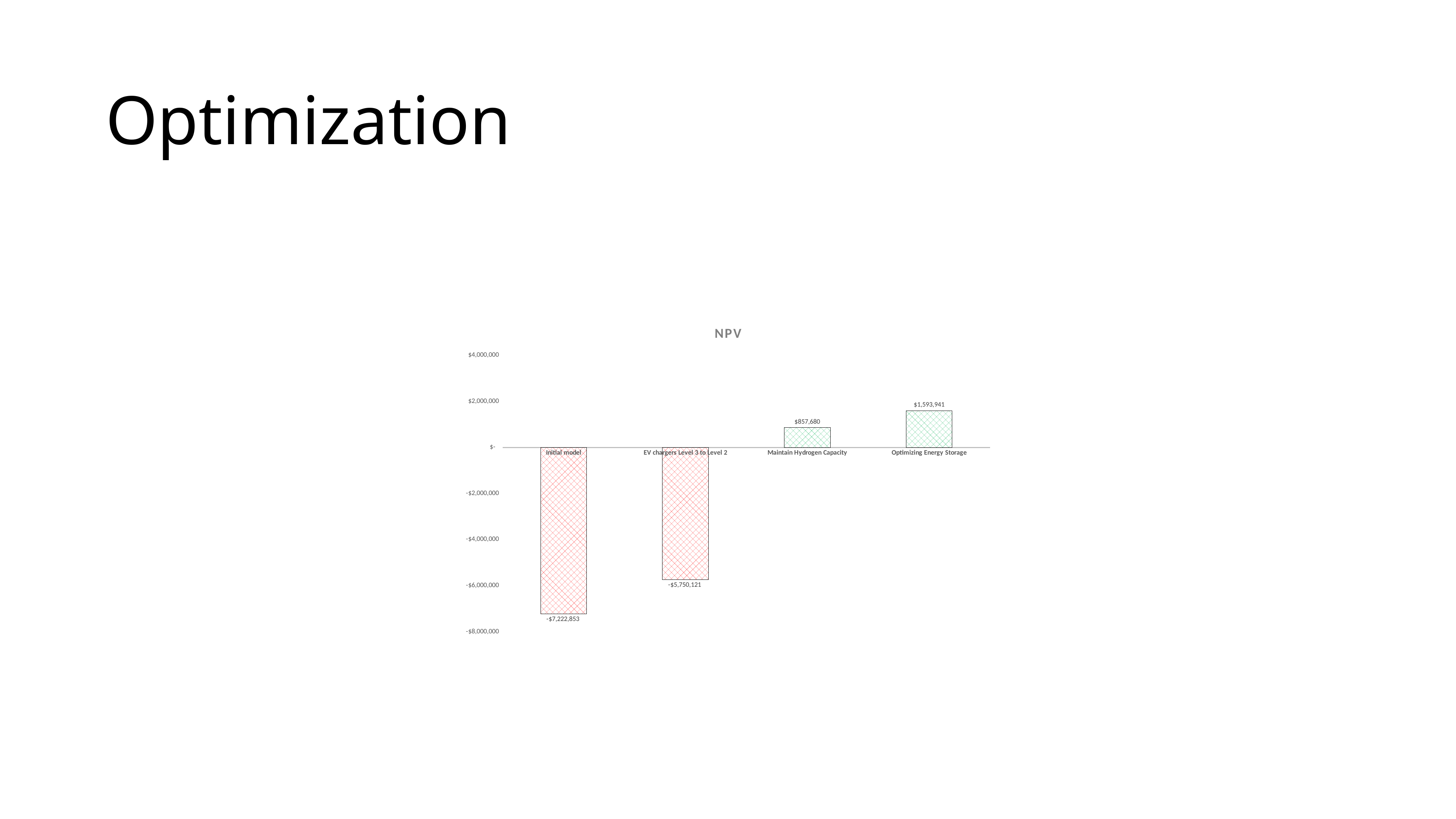
Which category has the highest NPV? Optimizing Energy Storage What is the NPV value for EV chargers Level 3 to Level 2? -$5,750,121 What is the NPV value for Initial model? -$7,222,853 What is the NPV value for Optimizing Energy Storage? $1,593,941 By how much does the NPV for EV chargers Level 3 to Level 2 exceed the NPV for Initial model? $1,472,732 What is the difference between the NPV for Optimizing Energy Storage and Maintain Hydrogen Capacity? $736,261 Which has a larger NPV, Maintain Hydrogen Capacity or Optimizing Energy Storage? Optimizing Energy Storage What is the title of the chart? NPV What is the NPV value for Maintain Hydrogen Capacity? $857,680 Which category has the lowest NPV? Initial model What kind of chart is shown on the slide? Bar chart How many categories are shown in the NPV chart? 4